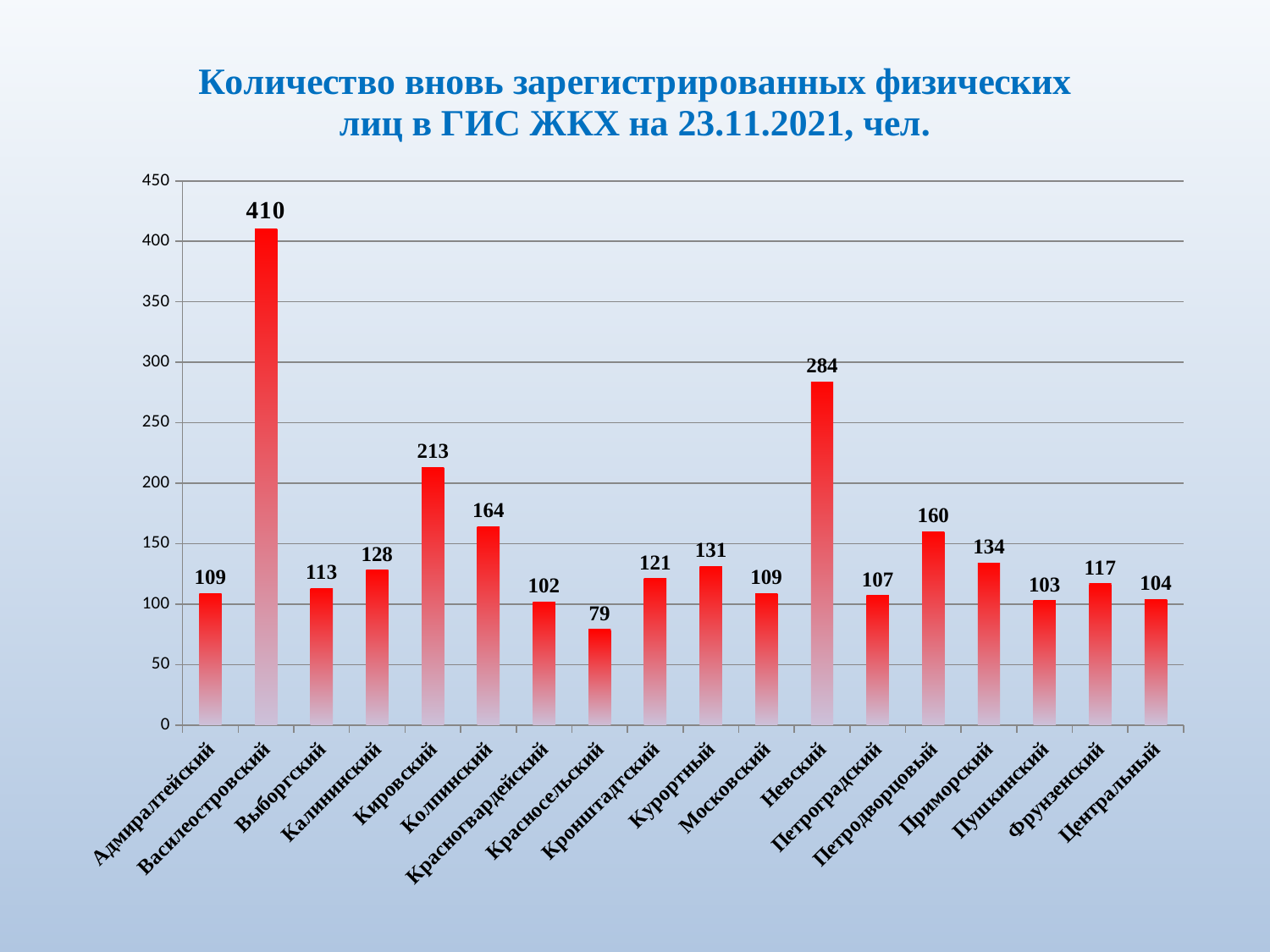
What date is given in the chart title? 23.11.2021 What is the difference between the values for Приморский and Пушкинский? 31 Which is larger, the value for Кировский or the value for Колпинский? Кировский What is the value for Петродворцовый? 160 What is the value for Красносельский? 79 What is the difference between the values for Василеостровский and Невский? 126 Which district has the lowest value? Красносельский What is the value for Невский? 284 Which district has the highest value? Василеостровский What is the value for Василеостровский? 410 How many districts are shown on the chart? 18 What kind of chart is shown on the slide? Bar chart